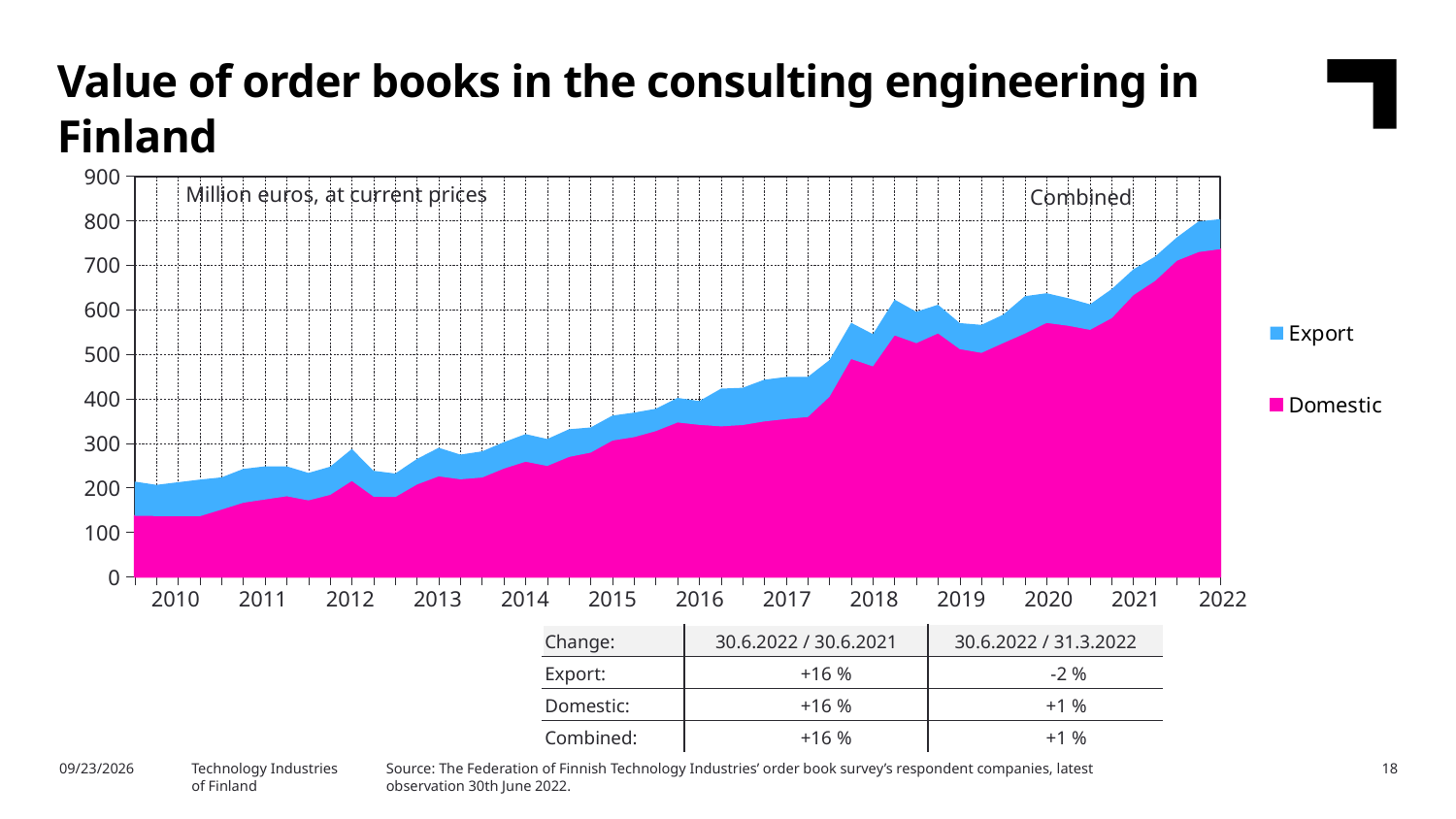
Which two series are listed in the legend? Export and Domestic According to the table, what is the change in Export order books from 31.3.2022 to 30.6.2022? -2 % Is the Domestic value at the start of 2010 greater or less than 200? less According to the table, what is the change in Export order books from 30.6.2021 to 30.6.2022? +16 % In which year shown on the x axis is the combined value highest? 2022 What unit is stated for the values in the chart? Million euros, at current prices In which year shown on the x axis is the combined value lowest? 2010 How many series does the legend list? 2 Is the combined value at the end of 2022 greater or less than 700? greater Do the combined order book values generally rise or fall from 2010 to 2022? Rise What kind of chart is shown on the slide? Stacked area chart Is the combined value at the start of 2010 greater or less than 300? less